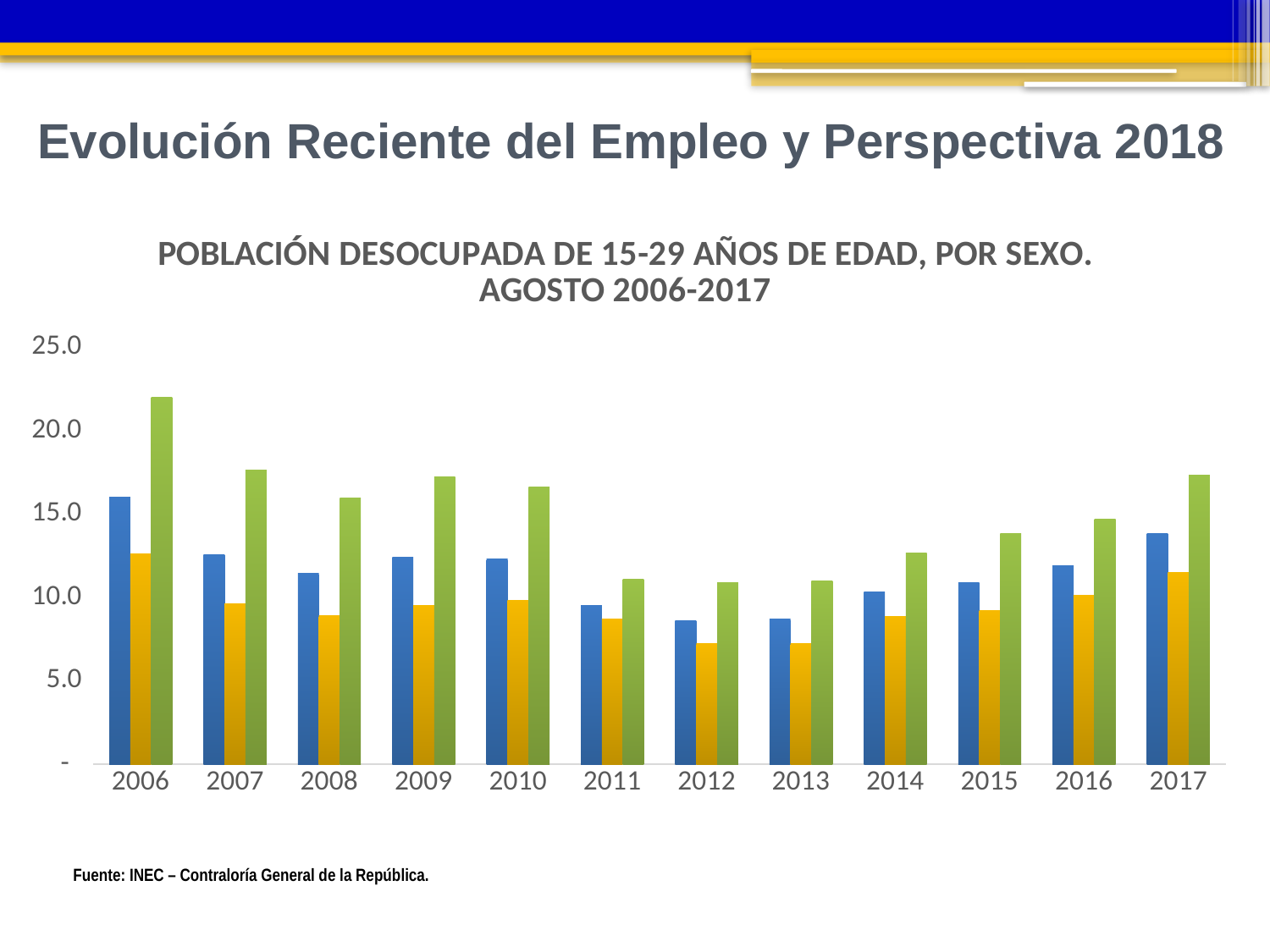
What kind of chart is shown on the slide? bar chart Do the green bars generally rise or fall from 2006 to 2012? fall Is the value of the yellow bar for 2012 greater or less than 10.0? less How many years are shown on the x axis of the chart? 12 Which is larger in 2006, the blue bar or the green bar? the green bar In which year is the blue bar the tallest? 2006 Is the value of the green bar for 2017 greater or less than 15.0? greater Is the value of the blue bar for 2017 greater or less than 15.0? less What is the title of the chart? POBLACIÓN DESOCUPADA DE 15-29 AÑOS DE EDAD, POR SEXO. AGOSTO 2006-2017 How many bars are plotted for each year in the chart? 3 In which year is the green bar the tallest? 2006